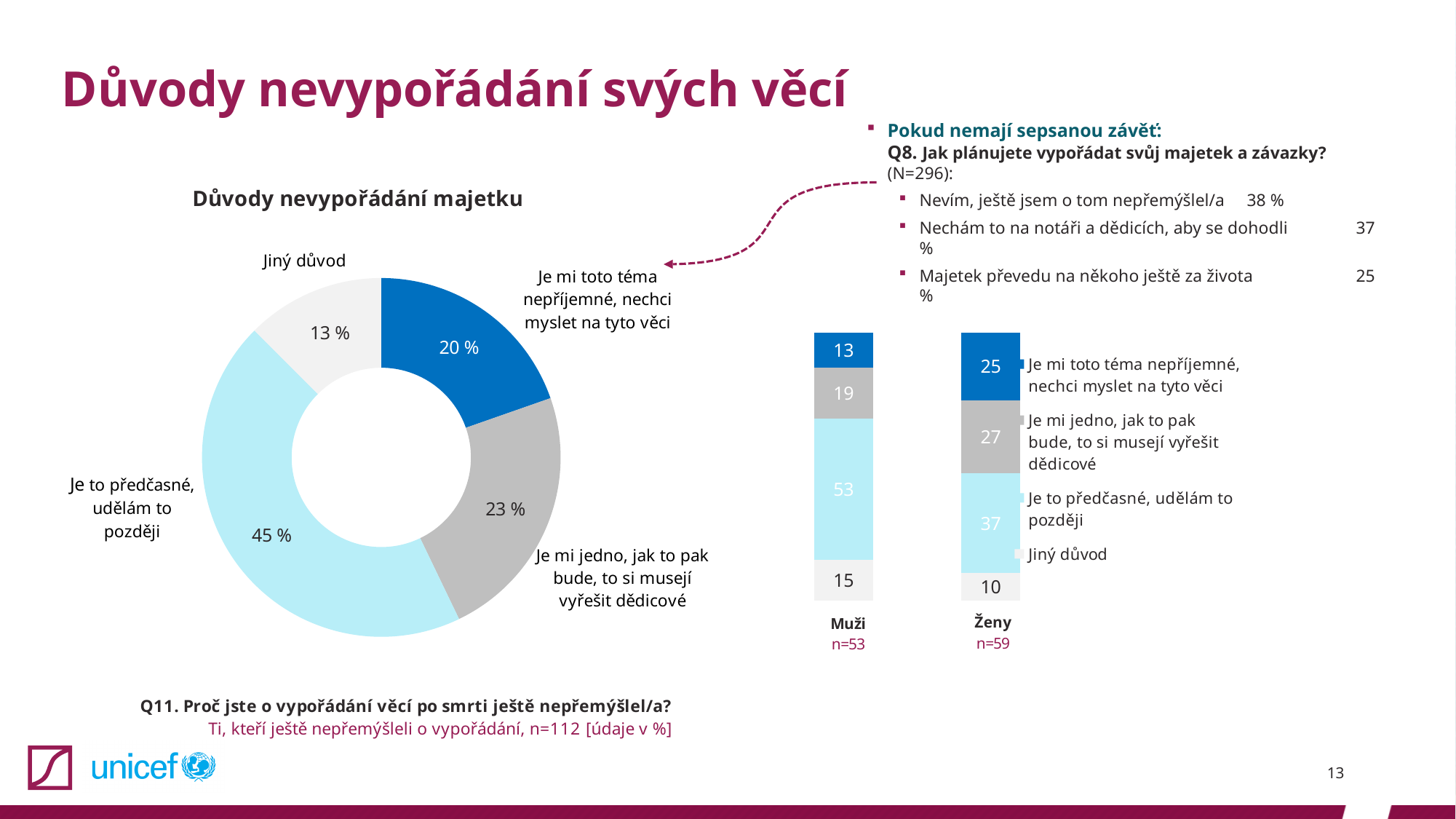
In the donut chart "Důvody nevypořádání majetku", which category has the smallest share? Jiný důvod In the stacked bar chart on the right, how many series does the legend list? 4 In the donut chart "Důvody nevypořádání majetku", what share is shown for "Je to předčasné, udělám to později"? 45 % In the donut chart "Důvody nevypořádání majetku", which category has the largest share? Je to předčasné, udělám to později In the stacked bar chart on the right, what is the value for "Je to předčasné, udělám to později" in the Muži bar? 53 What type of chart is the chart on the right of the slide with the Muži and Ženy bars? Stacked bar chart In the stacked bar chart on the right, what is the value for "Je mi toto téma nepříjemné, nechci myslet na tyto věci" in the Ženy bar? 25 In the donut chart "Důvody nevypořádání majetku", what share is shown for "Jiný důvod"? 13 % In the stacked bar chart on the right, which bar has the larger value for "Jiný důvod", Muži or Ženy? Muži In the donut chart "Důvody nevypořádání majetku", what is the difference between the shares for "Je mi jedno, jak to pak bude, to si musejí vyřešit dědicové" and "Je mi toto téma nepříjemné, nechci myslet na tyto věci"? 3 % In the donut chart "Důvody nevypořádání majetku", how many categories are shown? 4 In the stacked bar chart on the right, what is the difference between the Ženy and Muži values for "Je mi jedno, jak to pak bude, to si musejí vyřešit dědicové"? 8